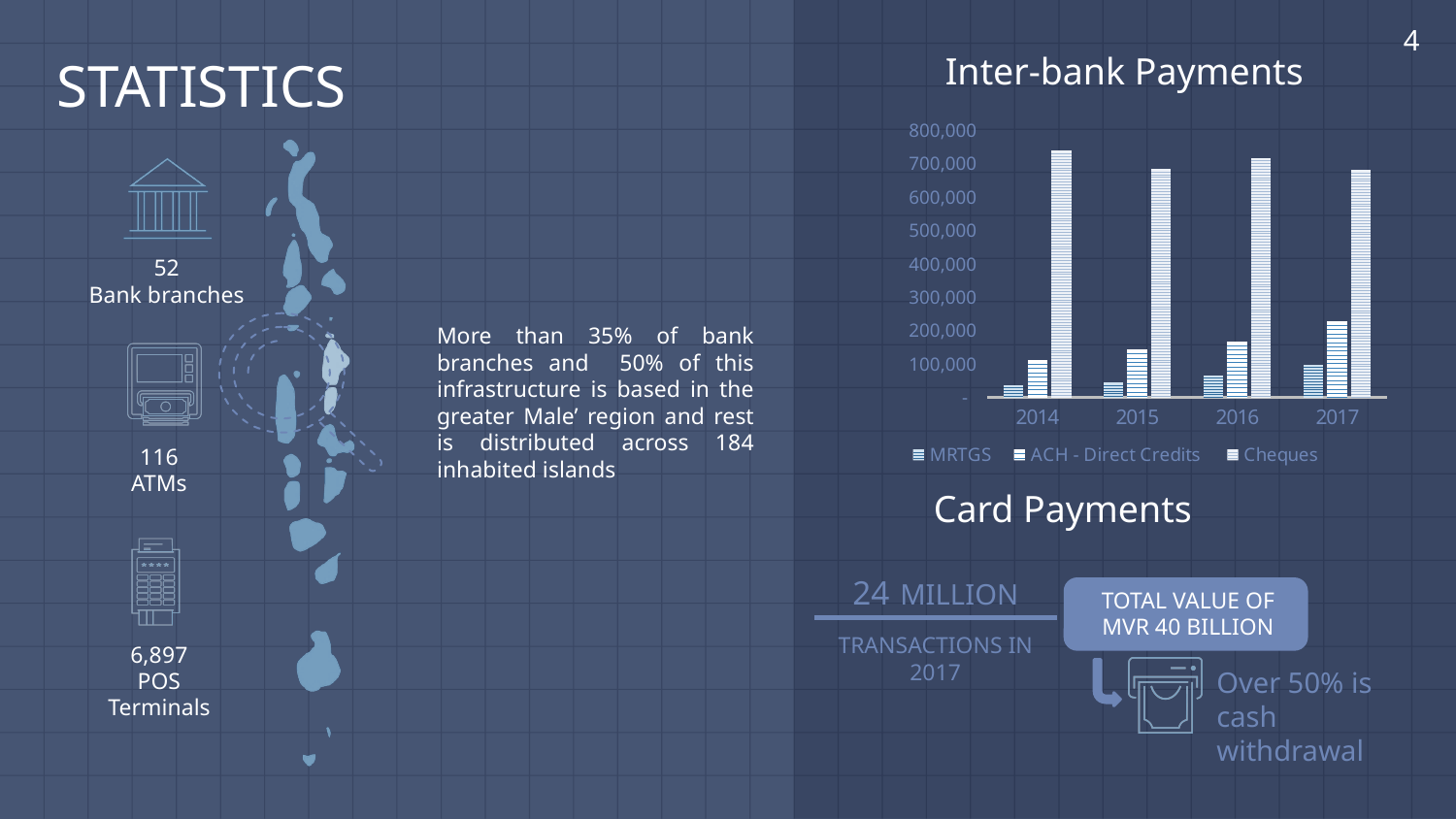
How many series does the legend of the Inter-bank Payments chart list? 3 In the Inter-bank Payments chart, which series has the lowest value in 2014? MRTGS In the Inter-bank Payments chart, does the ACH - Direct Credits series rise or fall from 2014 to 2017? rise In the Inter-bank Payments chart, which is larger: ACH - Direct Credits in 2017 or ACH - Direct Credits in 2014? ACH - Direct Credits in 2017 In the Inter-bank Payments chart, does the MRTGS series rise or fall from 2014 to 2017? rise In the Inter-bank Payments chart, is the value for MRTGS in 2015 greater or less than 100,000? less How many years are shown on the x axis of the Inter-bank Payments chart? 4 In the Inter-bank Payments chart, is the value for ACH - Direct Credits in 2017 greater or less than 200,000? greater In the Inter-bank Payments chart, which series has the highest value in 2017? Cheques What kind of chart is the Inter-bank Payments chart? bar chart In the Inter-bank Payments chart, is the value for Cheques in 2014 greater or less than 700,000? greater What is the title of the bar chart on the slide? Inter-bank Payments